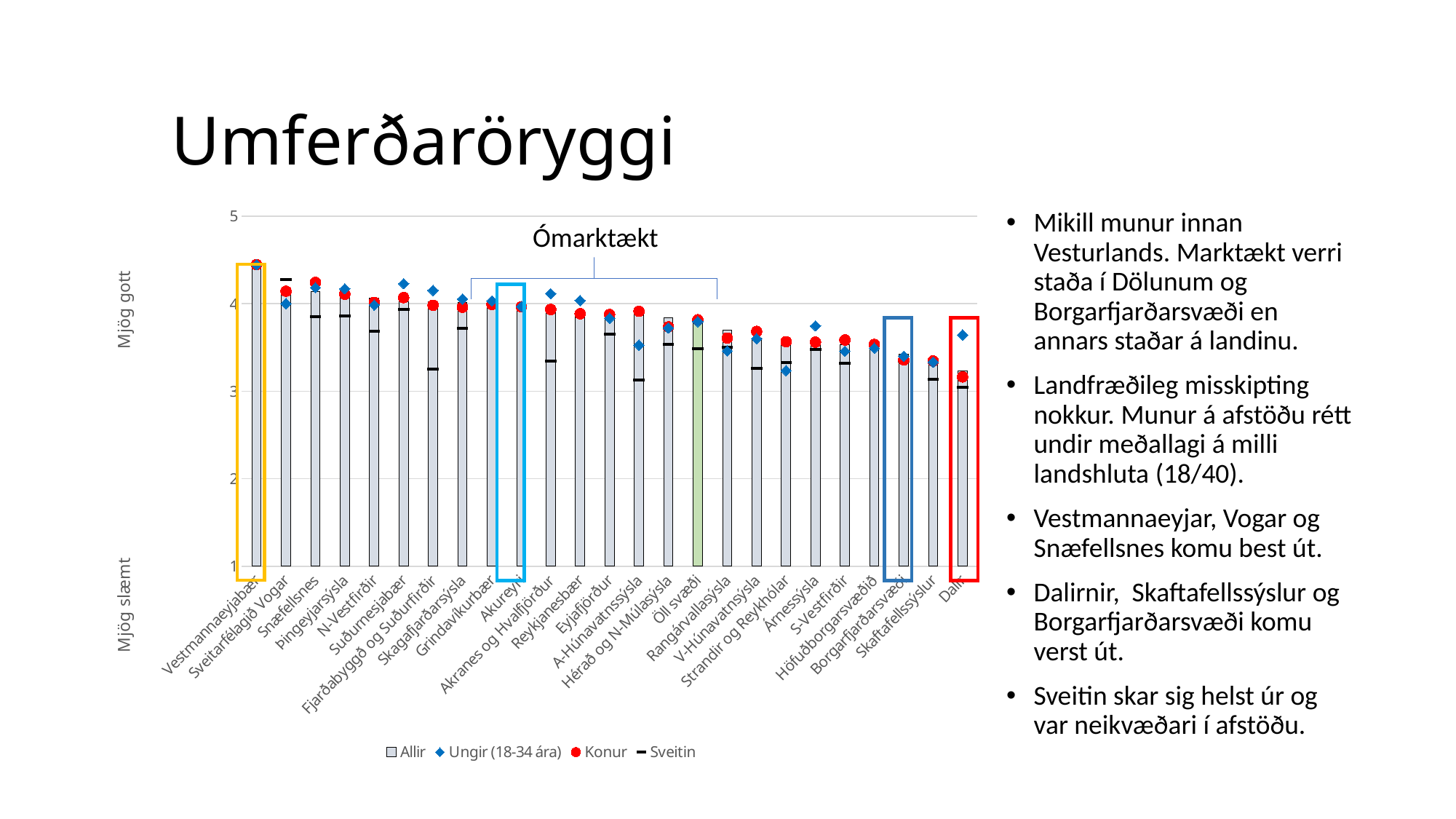
Is the Allir value for Dalir greater or less than 4? less Do the Allir bars generally rise or fall from left to right along the x axis? fall Is the Allir value for Snæfellsnes greater or less than 4? greater Is the Allir value for Vestmannaeyjabær greater or less than 4? greater How many categories are plotted along the x axis of the chart? 25 How many series does the chart legend list? 4 What kind of chart is shown on the slide? Bar chart Which series in the legend is shown with blue diamond markers? Ungir (18-34 ára) Which has the larger Allir value, Vestmannaeyjabær or Dalir? Vestmannaeyjabær Which category has the highest Allir bar? Vestmannaeyjabær Which category has the lowest Allir bar? Dalir